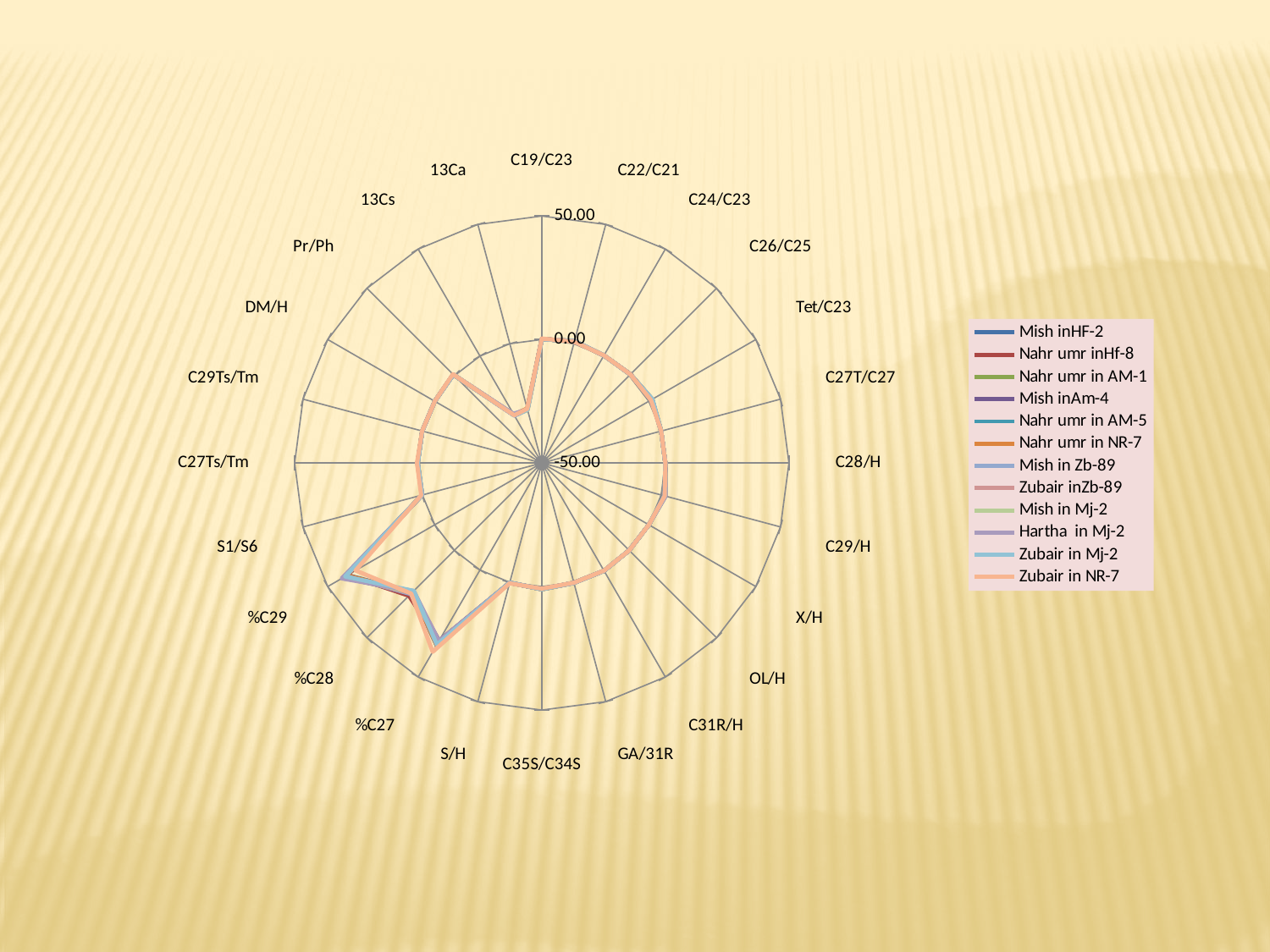
What kind of chart is shown on the slide? radar chart What is the first series listed in the legend? Mish inHF-2 How many series does the legend list? 12 Which has the larger value, %C27 or C19/C23? %C27 Is the value for %C27 greater or less than 0.00? greater What is the value shown at the outer ring of the radar chart's axis? 50.00 Is the value for %C29 greater or less than 50.00? less Which has the larger value, %C29 or 13Cs? %C29 Is the value for 13Cs greater or less than 0.00? less How many categories (axes) does the radar chart have? 24